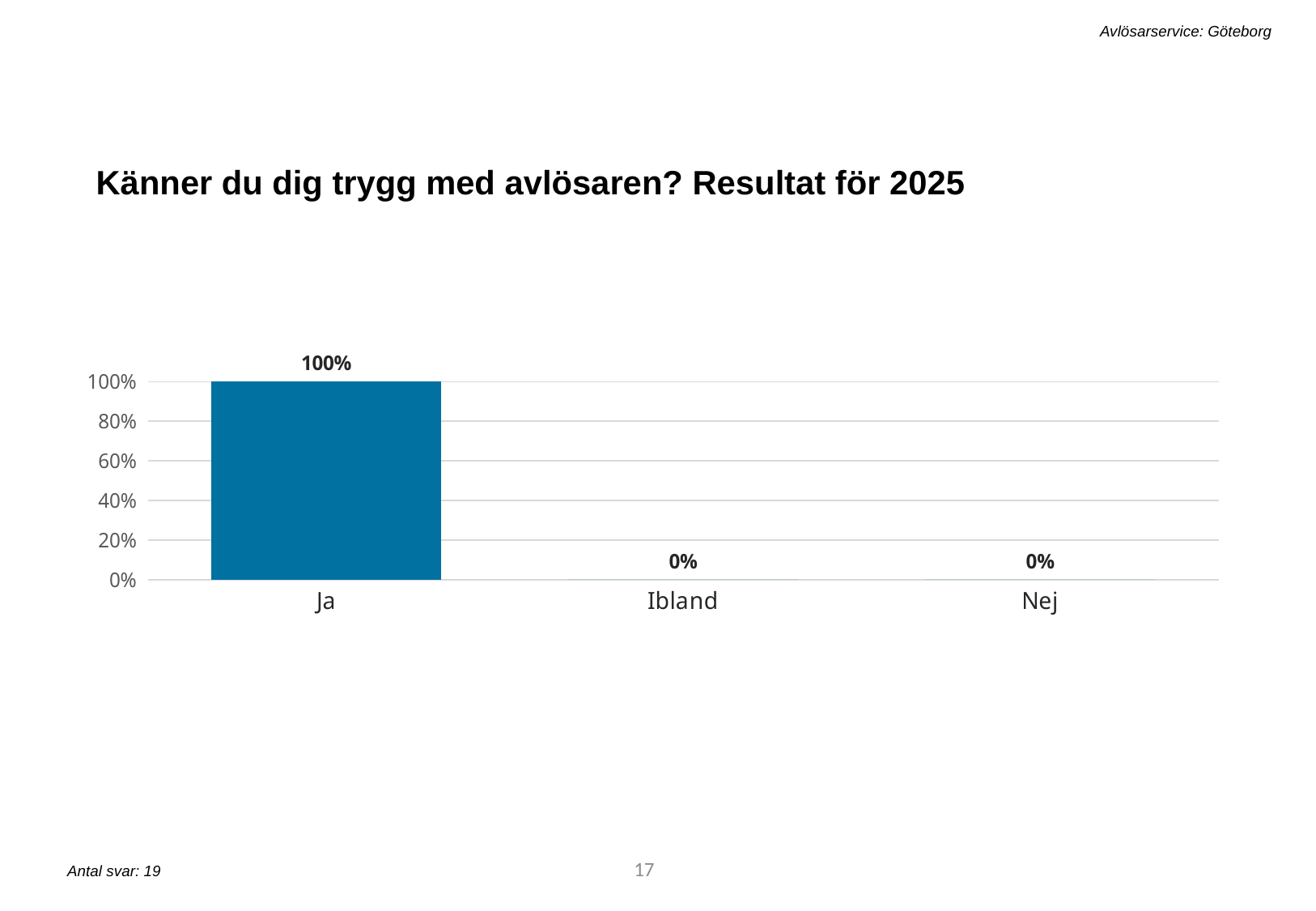
Which is larger, the value for Ja or the value for Ibland? Ja Do the values rise or fall from Ja to Nej along the x axis? fall How many categories are shown on the x axis? 3 What is the value for Ibland? 0% Is the value for Ja greater or less than 80%? greater What is the difference between the values for Ja and Nej? 100% Which category has the highest value? Ja What is the title of the chart? Känner du dig trygg med avlösaren? Resultat för 2025 What is the highest value shown on the y axis? 100% What is the value for Nej? 0% What is the value for Ja? 100% What kind of chart is shown on the slide? bar chart